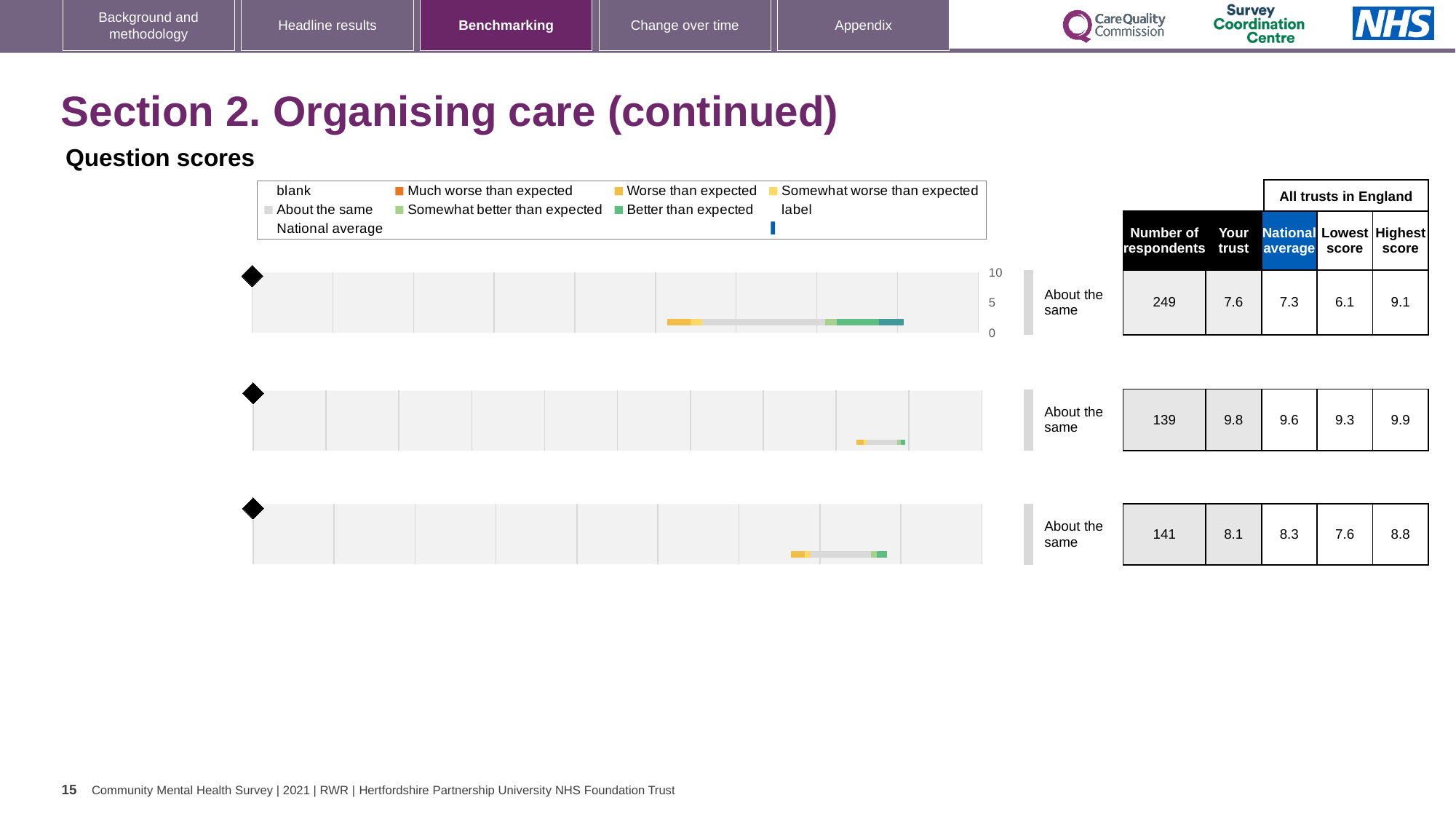
For the middle chart, what is the 'Your trust' score shown in the table? 9.8 For the top chart, what is the number of respondents shown in the table? 249 Which of the three charts has the highest number of respondents? The top chart (249) For the top chart, which is larger: the 'Your trust' score or the national average? Your trust How many benchmarking bar charts are shown on the slide? 3 For the top chart, what is the difference between the highest score and the lowest score across all trusts in England? 3.0 For the middle chart, what is the difference between the highest score and the lowest score across all trusts in England? 0.6 For the bottom chart, what is the national average shown in the table? 8.3 For the bottom chart, which is larger: the 'Your trust' score or the national average? National average What kind of chart is used for the three benchmarking rows on the slide? bar chart For the top chart, what is the lowest score across all trusts in England? 6.1 What benchmarking category label is shown next to each of the three charts? About the same